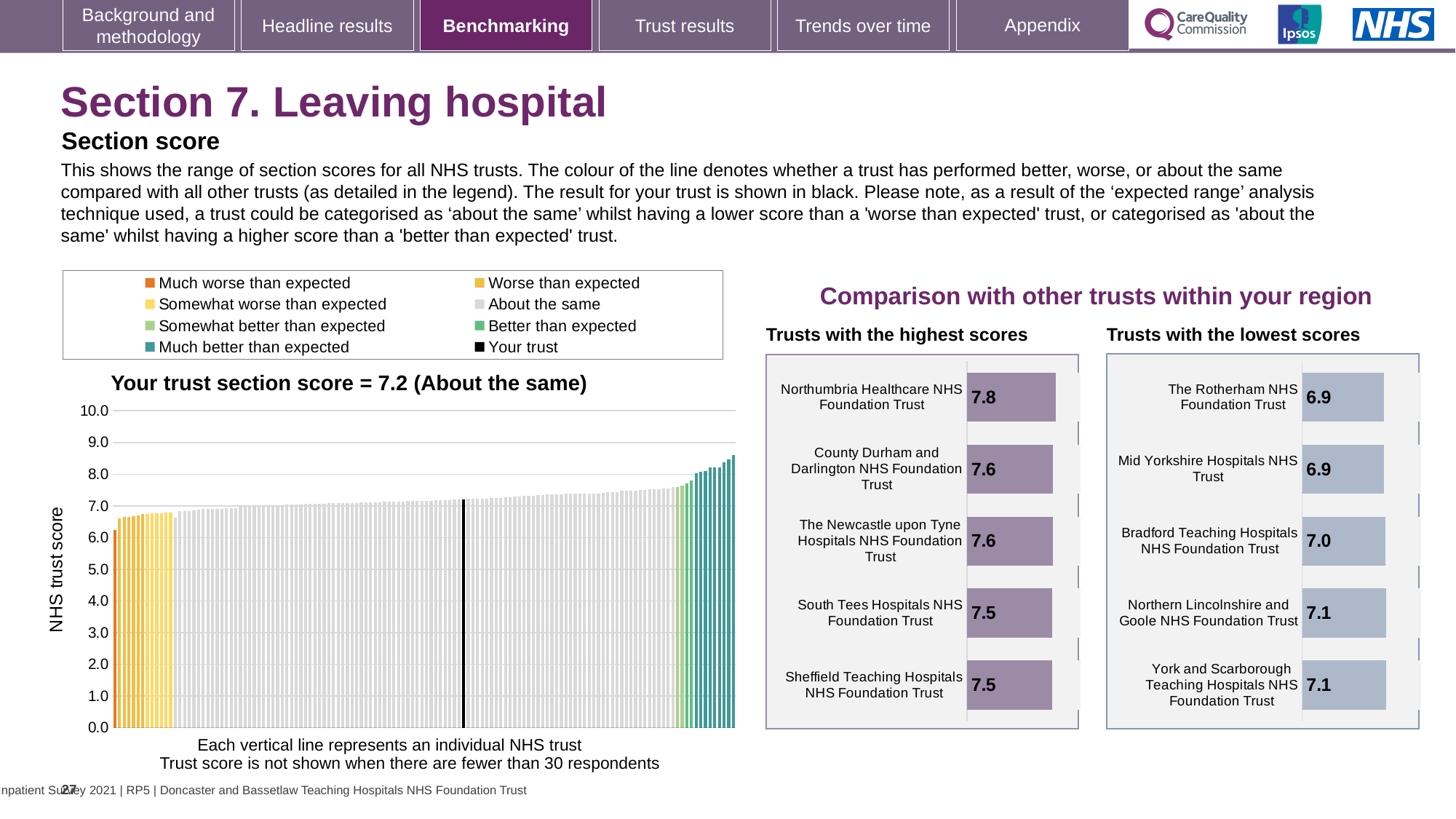
In the 'Trusts with the lowest scores' chart, what is the score for Bradford Teaching Hospitals NHS Foundation Trust? 7.0 What is the y-axis label of the 'Your trust section score' chart? NHS trust score In the 'Trusts with the highest scores' chart, what is the difference between the scores of Northumbria Healthcare NHS Foundation Trust and Sheffield Teaching Hospitals NHS Foundation Trust? 0.3 In the 'Your trust section score' chart, do the trust scores rise or fall from left to right along the x axis? rise In the 'Trusts with the highest scores' chart, which trust has the highest score? Northumbria Healthcare NHS Foundation Trust How many entries does the legend above the 'Your trust section score' chart list? 8 What kind of chart is the 'Your trust section score' chart? bar chart How many trusts are shown in the 'Trusts with the lowest scores' chart? 5 In the 'Your trust section score' chart, what is the section score for your trust? 7.2 In the 'Trusts with the highest scores' chart, what is the score for Northumbria Healthcare NHS Foundation Trust? 7.8 In the 'Trusts with the lowest scores' chart, which has the larger score: Bradford Teaching Hospitals NHS Foundation Trust or The Rotherham NHS Foundation Trust? Bradford Teaching Hospitals NHS Foundation Trust In the 'Your trust section score' chart, is the value of the tallest bar on the right greater or less than 8.0? greater